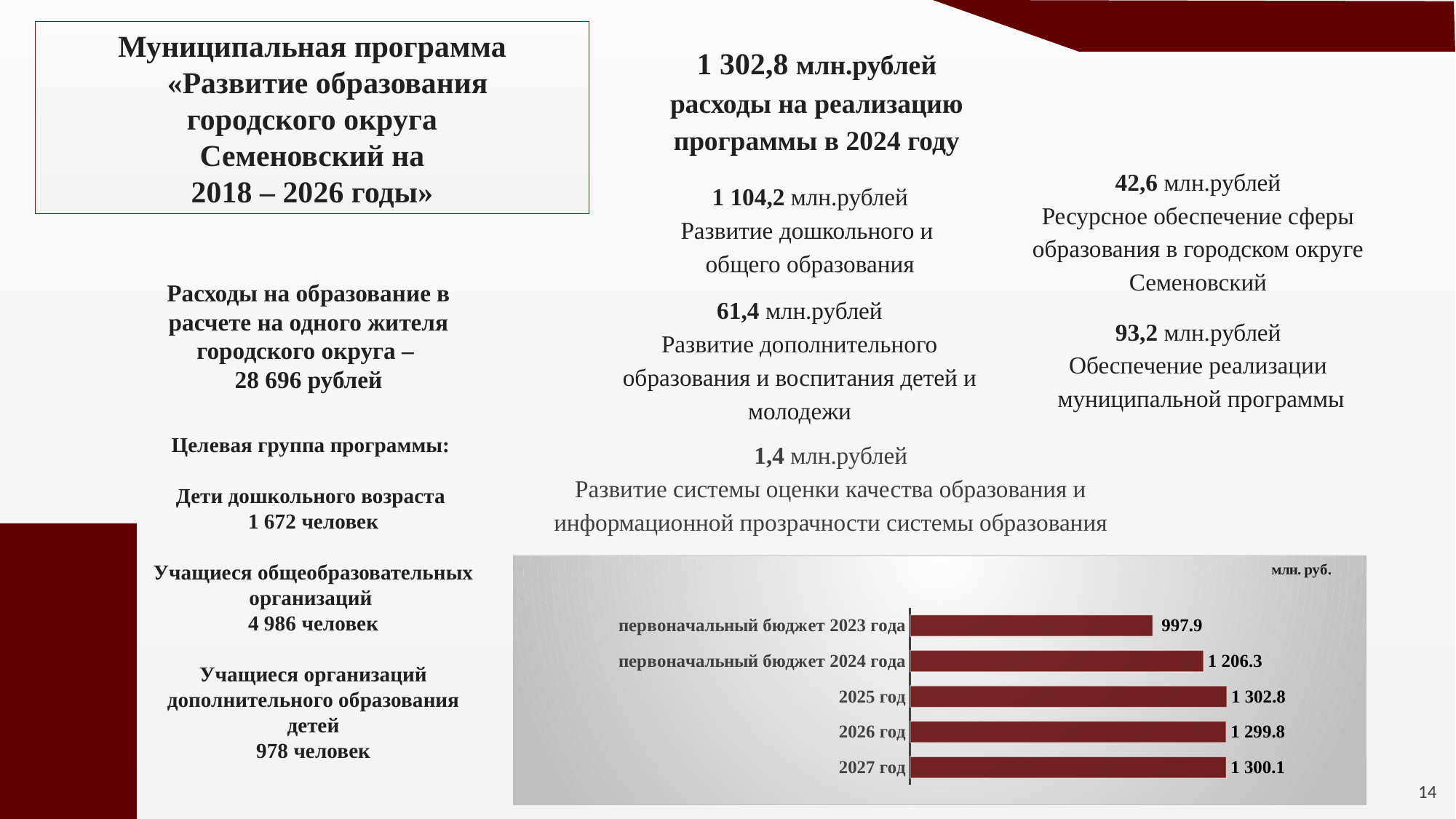
What type of chart is shown on the slide? bar chart Which is larger: the value for первоначальный бюджет 2024 года or for первоначальный бюджет 2023 года? первоначальный бюджет 2024 года What is the value for первоначальный бюджет 2024 года? 1 206.3 What is the value for 2025 год? 1 302.8 What unit is indicated in the top right corner of the chart? млн. руб. What is the value for первоначальный бюджет 2023 года? 997.9 What is the difference between the values for первоначальный бюджет 2024 года and первоначальный бюджет 2023 года? 208.4 What is the difference between the values for 2025 год and 2026 год? 3.0 Which category has the lowest value in the chart? первоначальный бюджет 2023 года What is the value for 2027 год? 1 300.1 How many bars (categories) does the chart show? 5 Which category has the highest value in the chart? 2025 год